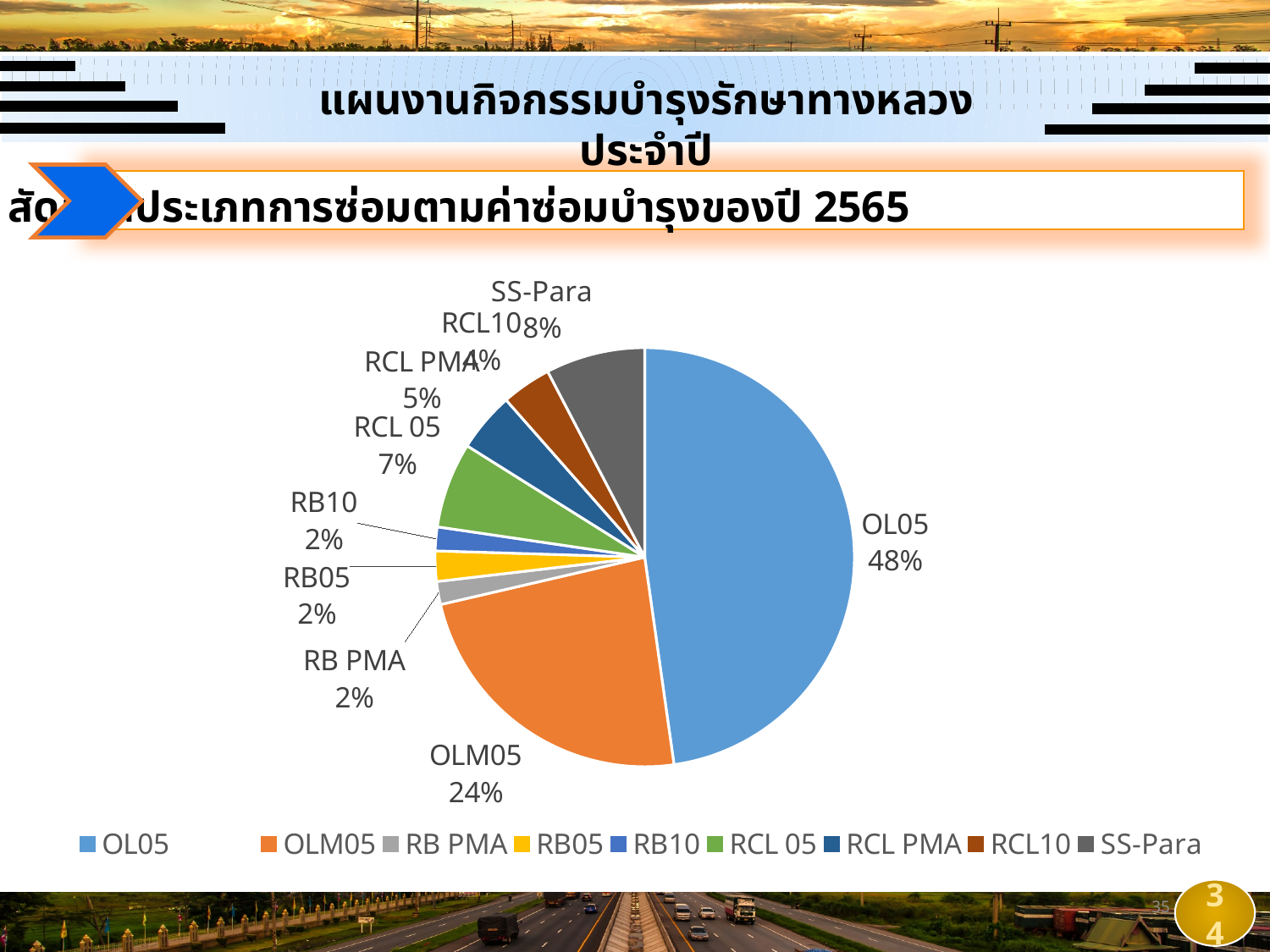
What is the difference in percentage points between OL05 and OLM05? 24 What share of the pie does SS-Para have? 8% What share of the pie does OL05 have? 48% What colour is the OLM05 slice in the pie chart? orange Which category has the largest slice of the pie? OL05 What share of the pie does RCL PMA have? 5% What kind of chart is shown on the slide? pie chart How many categories does the legend list? 9 Which is larger, the share for SS-Para or the share for RCL 05? SS-Para